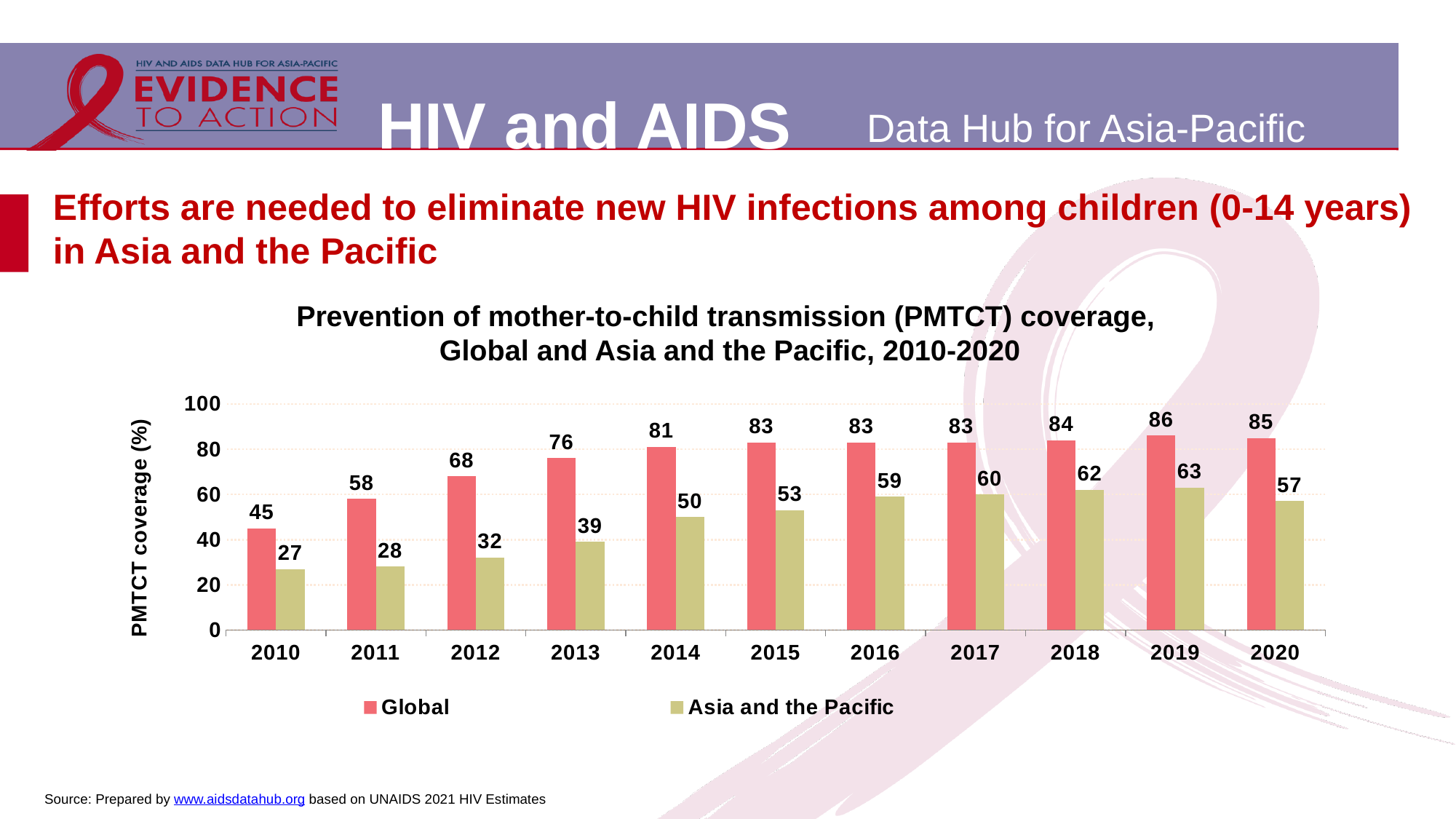
Which is larger in 2013: the Global value or the Asia and the Pacific value? Global What is the label of the y axis? PMTCT coverage (%) What is the difference between the Global and Asia and the Pacific values in 2020? 28 What is the Asia and the Pacific PMTCT coverage value for 2019? 63 In which year is the Asia and the Pacific PMTCT coverage lowest? 2010 Is the Asia and the Pacific value for 2012 greater or less than 40? less Does the Asia and the Pacific PMTCT coverage rise or fall from 2010 to 2019? rise What kind of chart is shown on the slide? bar chart What is the Global PMTCT coverage value for 2014? 81 How many series does the legend list? 2 In which year is the Global PMTCT coverage highest? 2019 How many years are shown on the x axis? 11